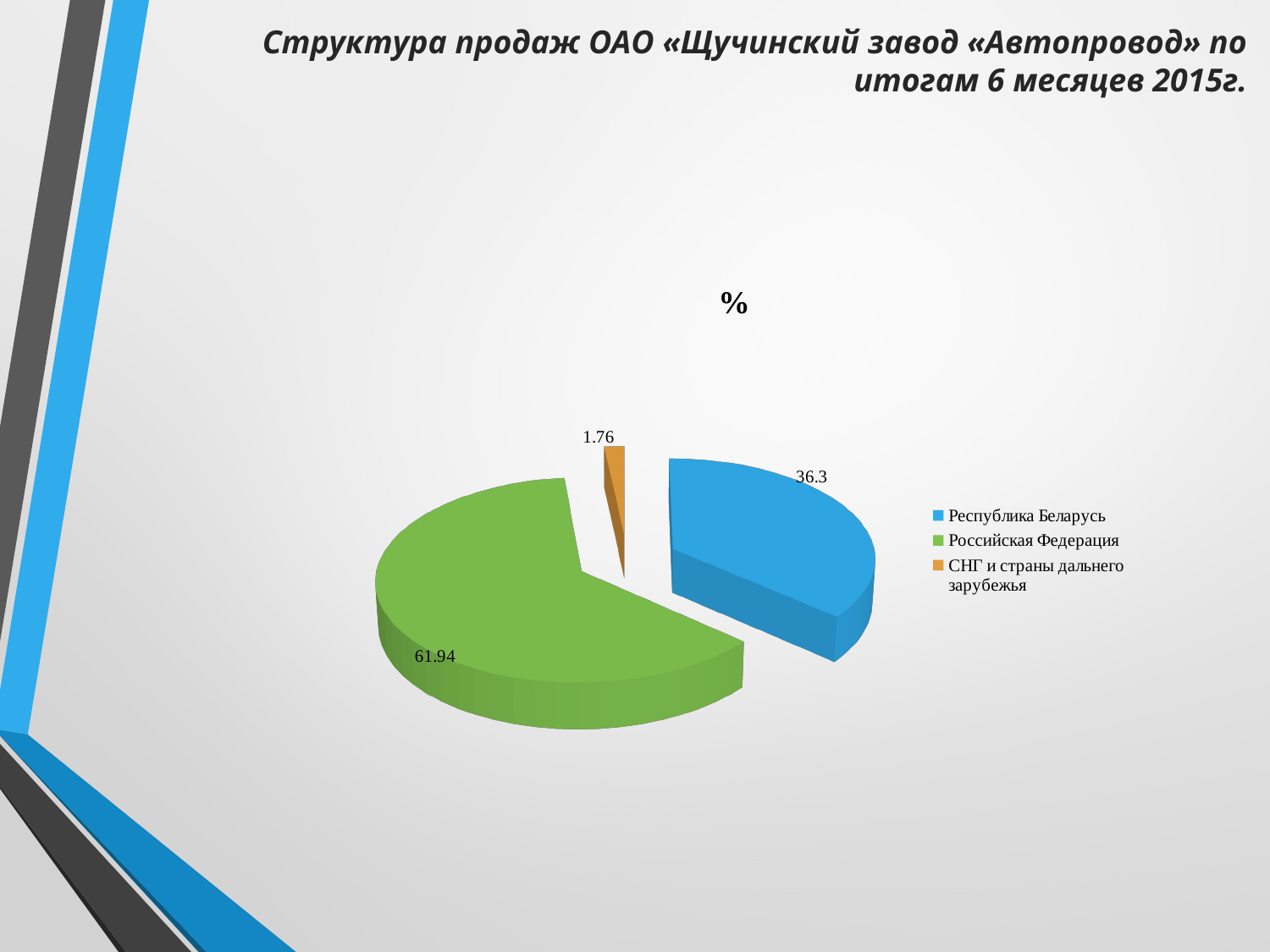
What is the title of the chart? % What is the difference between the values for Российская Федерация and Республика Беларусь? 25.64 Which is larger, the value for Республика Беларусь or the value for СНГ и страны дальнего зарубежья? Республика Беларусь How many entries does the legend list? 3 How many slices does the pie chart have? 3 What is the value for Республика Беларусь? 36.3 What kind of chart is shown on the slide? pie chart What colour is the slice for Российская Федерация? green What is the value for Российская Федерация? 61.94 Which category has the smallest slice? СНГ и страны дальнего зарубежья Which category has the largest slice? Российская Федерация What is the value for СНГ и страны дальнего зарубежья? 1.76